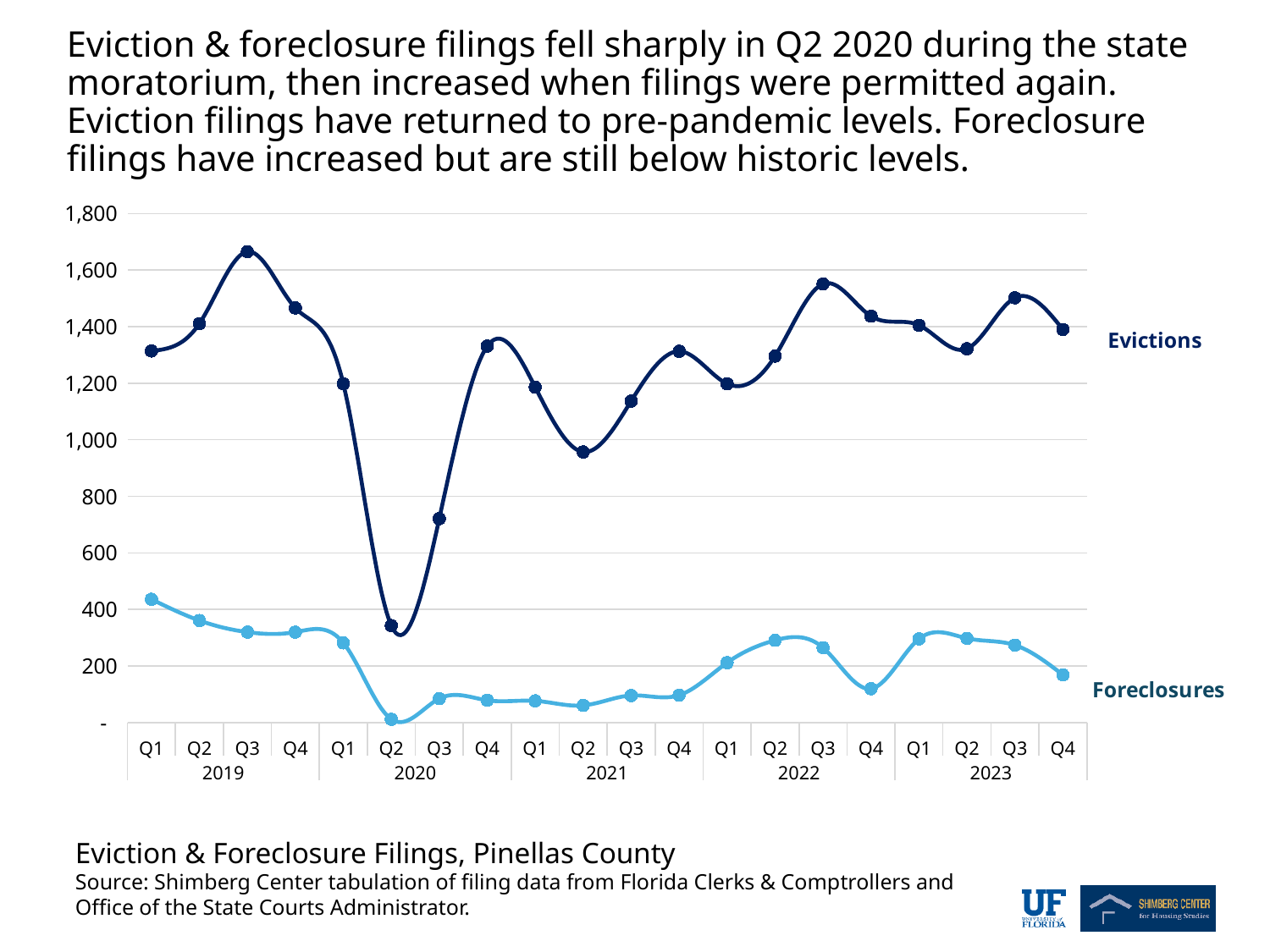
In which quarter do eviction filings reach their lowest point? Q2 2020 In which quarter do foreclosure filings reach their lowest point? Q2 2020 In which quarter do foreclosure filings reach their highest point? Q1 2019 Is the value for Foreclosures in Q4 2022 greater or less than 200? less Which is higher: eviction filings in Q3 2019 or in Q3 2022? Q3 2019 What kind of chart is shown on the slide? Line chart Is the value for Evictions in Q3 2019 greater or less than 1,600? greater How many series does the chart show? 2 In which quarter do eviction filings reach their highest point? Q3 2019 What is the title of the chart? Eviction & Foreclosure Filings, Pinellas County Is the value for Evictions in Q2 2020 greater or less than 400? less How many quarterly data points does each line have? 20